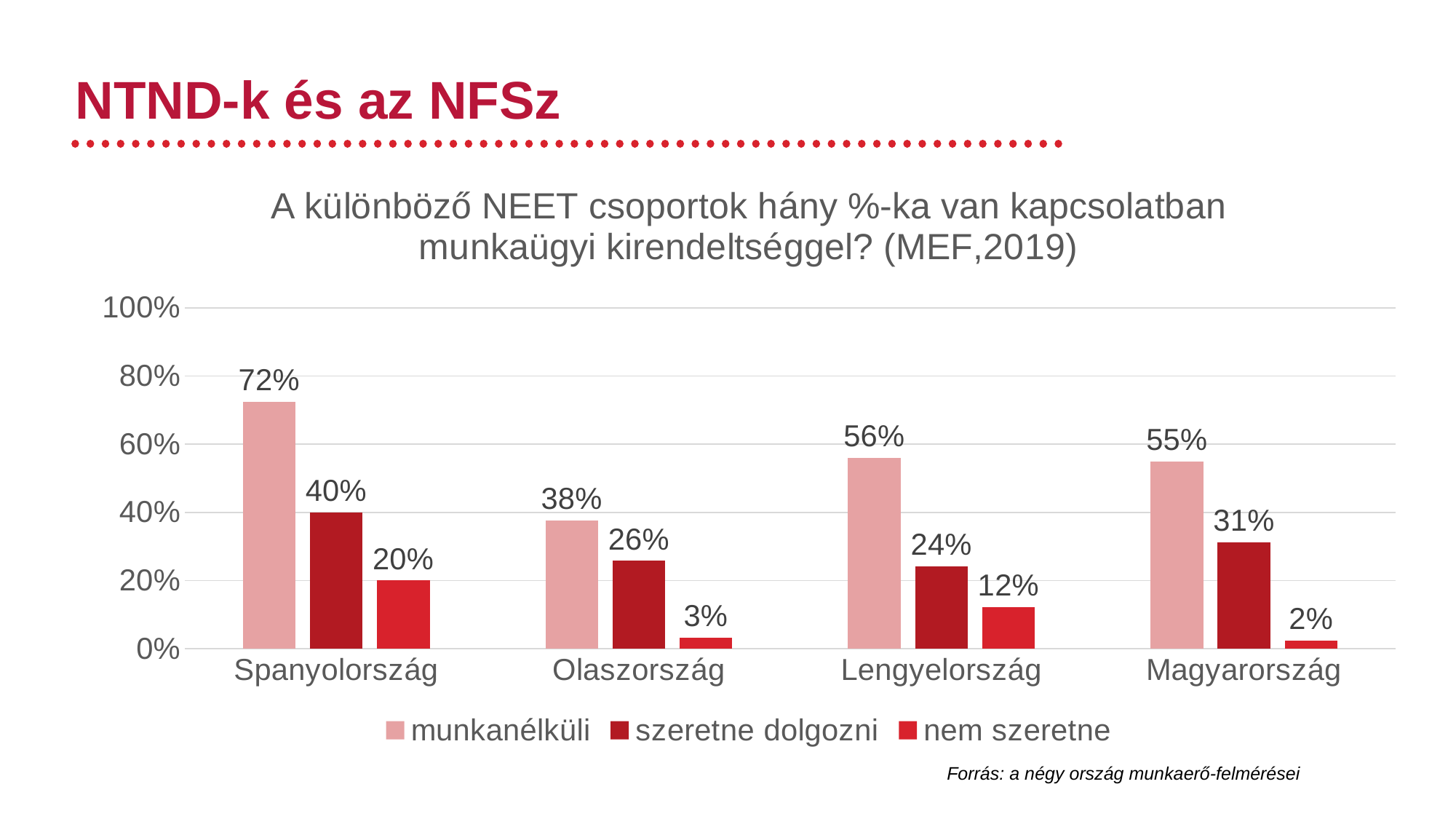
What is the difference between the "munkanélküli" and "szeretne dolgozni" values in Lengyelország? 32% What is the value for "nem szeretne" in Olaszország? 3% How many series does the legend list? 3 What is the value for "munkanélküli" in Spanyolország? 72% What kind of chart is shown on the slide? bar chart Which is larger: "szeretne dolgozni" in Spanyolország or "szeretne dolgozni" in Olaszország? Spanyolország Which country has the highest value for "munkanélküli"? Spanyolország Is the value for "munkanélküli" in Olaszország greater or less than 40%? less Which country has the lowest value for "nem szeretne"? Magyarország What is the source given below the chart? a négy ország munkaerő-felmérései How many countries are shown on the x axis? 4 What is the value for "szeretne dolgozni" in Magyarország? 31%